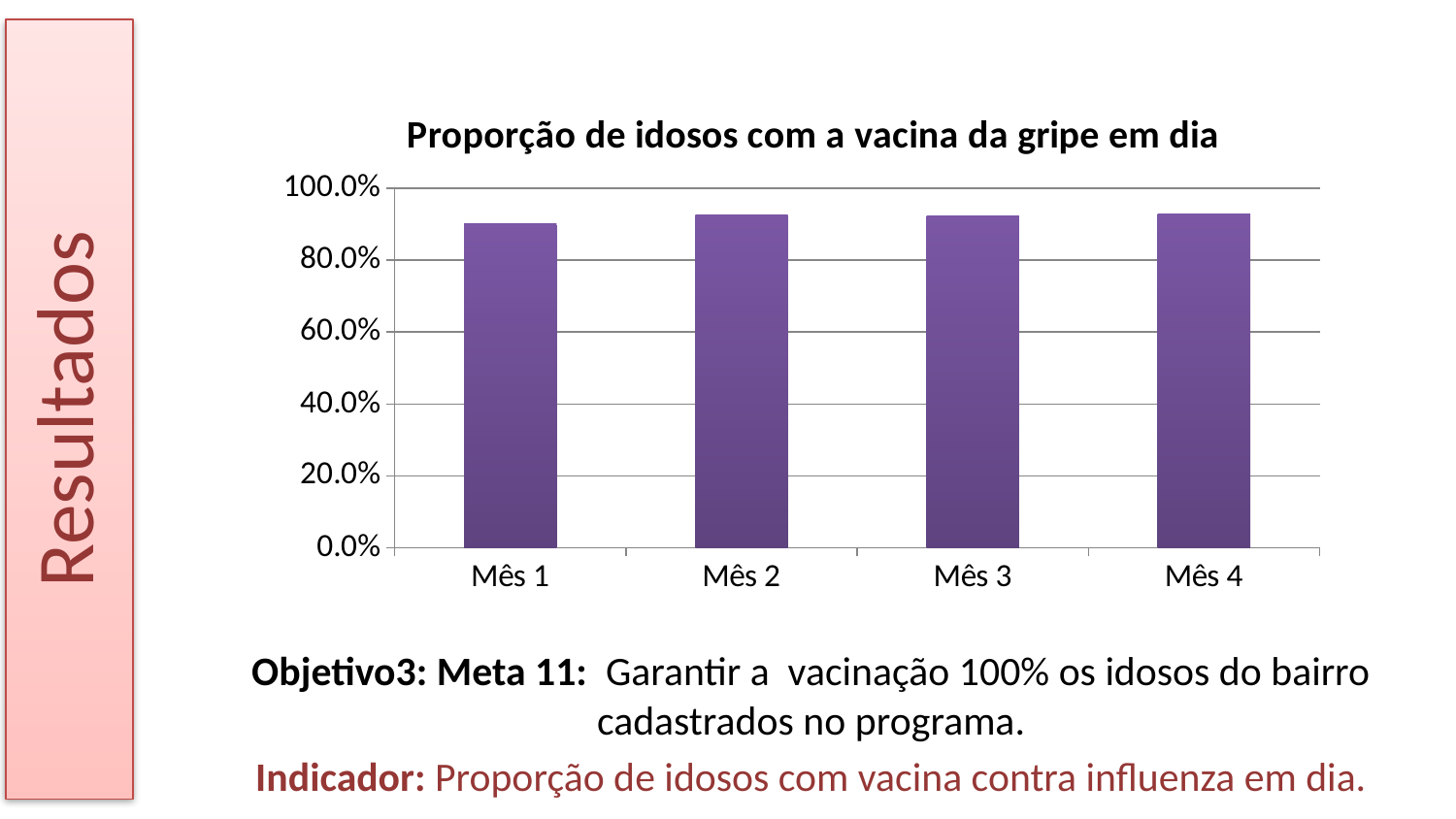
Is the value for Mês 1 greater or less than 80.0%? greater What type of chart is shown on the slide? bar chart What is the title of the chart? Proporção de idosos com a vacina da gripe em dia Which is larger, the value for Mês 1 or the value for Mês 4? Mês 4 Is the value for Mês 4 greater or less than 100.0%? less What is the highest value shown on the y axis of the chart? 100.0% How many categories (months) are shown on the x axis of the chart? 4 Is the value for Mês 2 greater or less than 80.0%? greater Which is larger, the value for Mês 1 or the value for Mês 2? Mês 2 Which month has the lowest value in the chart? Mês 1